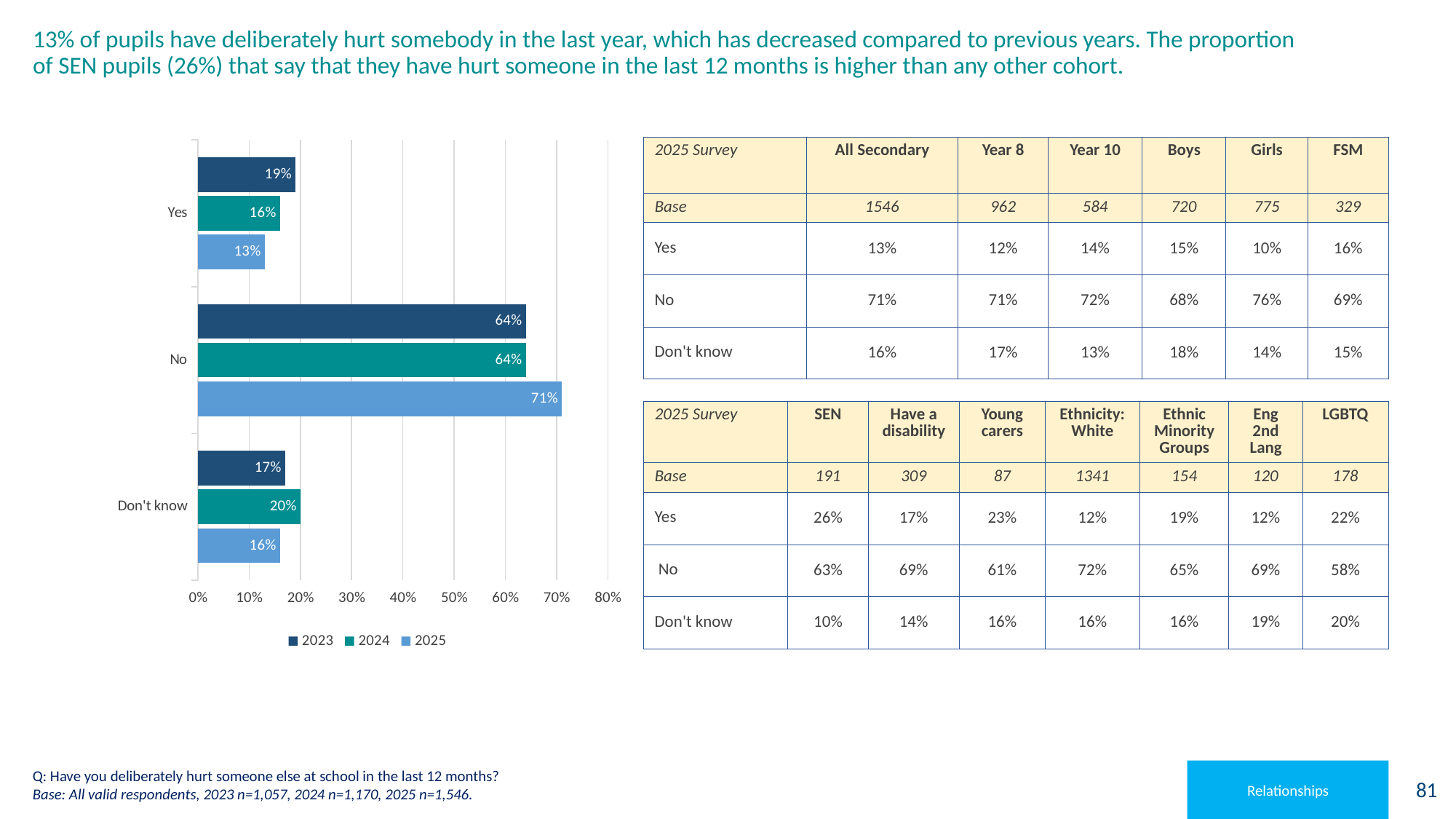
What is the value for 'No' in 2023? 64% What is the value for 'Yes' in 2025? 13% What kind of chart is shown on the slide? Bar chart How many series does the legend list? 3 Does the value for 'Yes' rise or fall from 2023 to 2025? Fall How many categories are shown on the chart? 3 Which is larger for 'Don't know': the 2024 value or the 2025 value? 2024 Which category has the lowest value in the 2025 series? Yes Which category has the highest value in the 2025 series? No What is the value for 'Don't know' in 2024? 20% What is the difference between the 2023 and 2025 values for 'Yes'? 6 percentage points What is the difference between the 2025 and 2023 values for 'No'? 7 percentage points